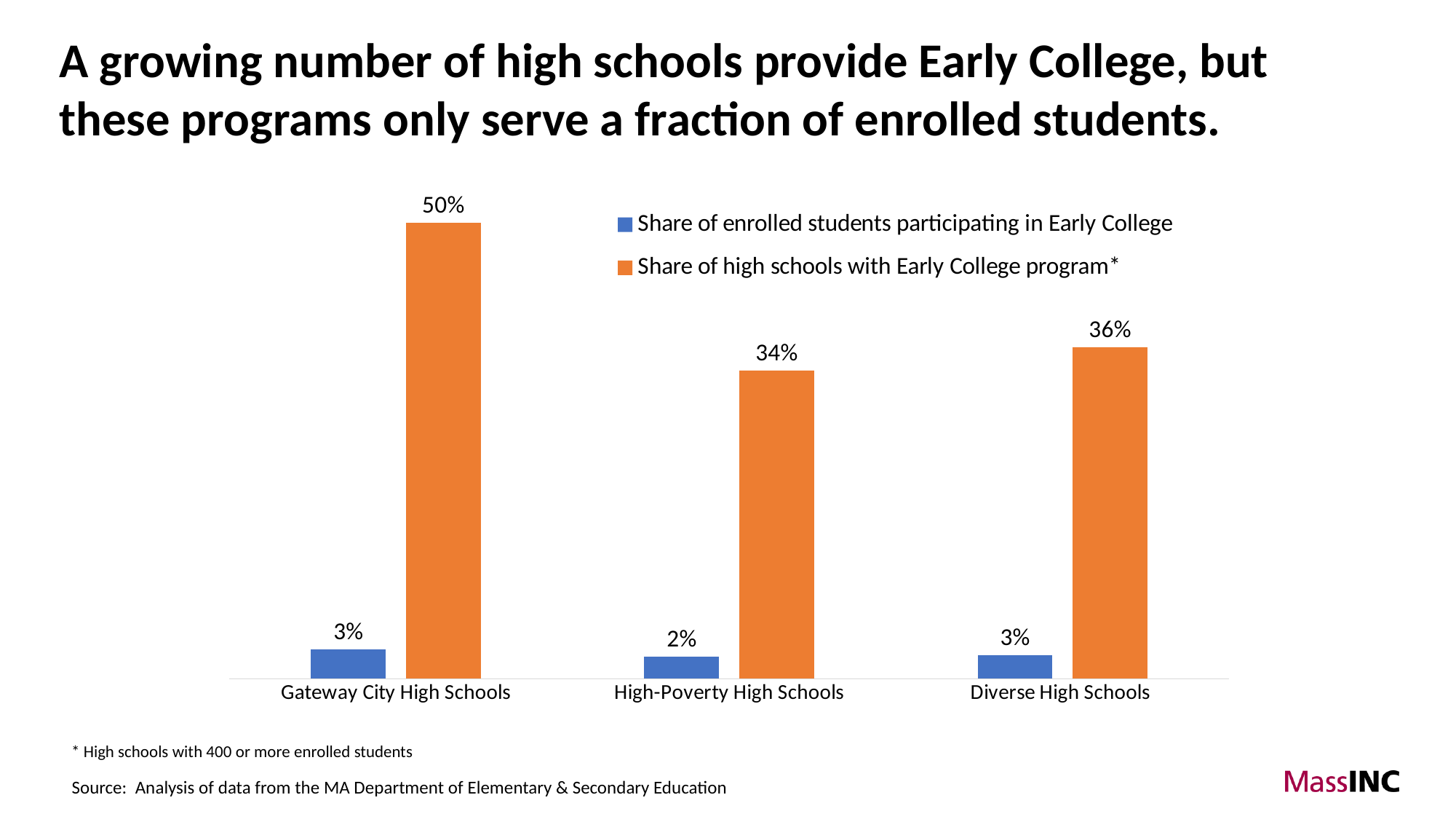
What is the share of enrolled students participating in Early College at High-Poverty High Schools? 2% Which is larger: the share of high schools with an Early College program for Diverse High Schools or for High-Poverty High Schools? Diverse High Schools What is the difference between the share of high schools with an Early College program for Gateway City High Schools and for High-Poverty High Schools? 16 percentage points What is the share of high schools with an Early College program for Diverse High Schools? 36% Which colour represents the share of high schools with an Early College program? Orange Which category has the highest share of high schools with an Early College program? Gateway City High Schools What is the share of enrolled students participating in Early College at Diverse High Schools? 3% How many categories are shown on the x axis of the chart? 3 What kind of chart is shown on the slide? Bar chart How many series does the legend list? 2 What is the share of high schools with an Early College program for Gateway City High Schools? 50% Which category has the lowest share of enrolled students participating in Early College? High-Poverty High Schools